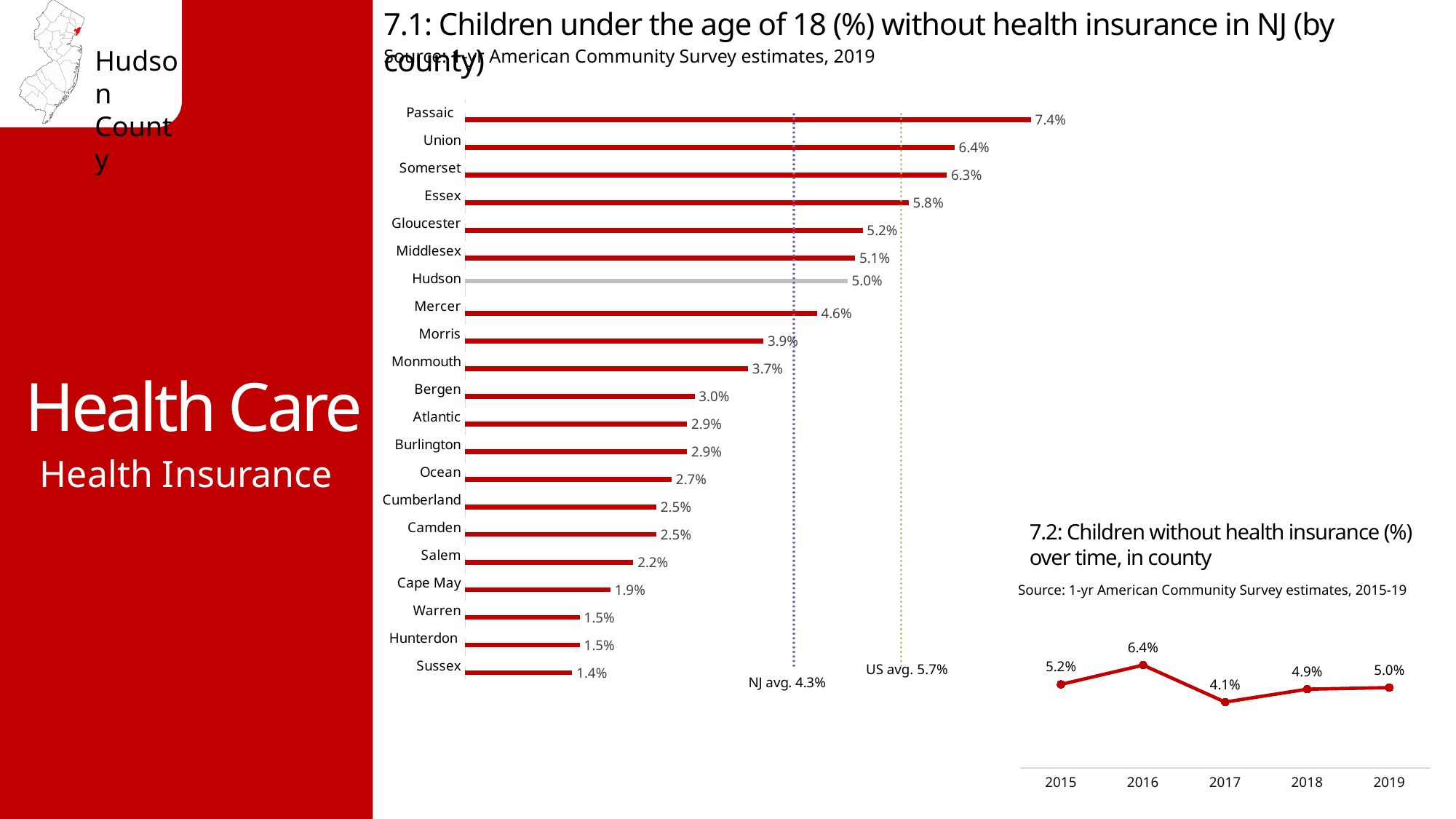
In chart 7.1, what is the value for Monmouth? 3.7% In chart 7.1, what NJ average is marked by the dotted reference line? 4.3% In chart 7.2, what is the value for 2017? 4.1% In chart 7.1, how many counties are plotted? 21 In chart 7.1, which county has the lowest percentage of children without health insurance? Sussex In chart 7.1 (children under 18 without health insurance by county), what is the value for Hudson? 5.0% What kind of chart is chart 7.2 (children without health insurance over time)? line chart In chart 7.1, which county has the highest percentage of children without health insurance? Passaic In chart 7.1, which county has a larger value, Essex or Mercer? Essex In chart 7.1, what is the difference between the values for Passaic and Sussex? 6.0% In chart 7.2, which year has the highest value? 2016 In chart 7.2, what is the difference between the values for 2016 and 2017? 2.3%